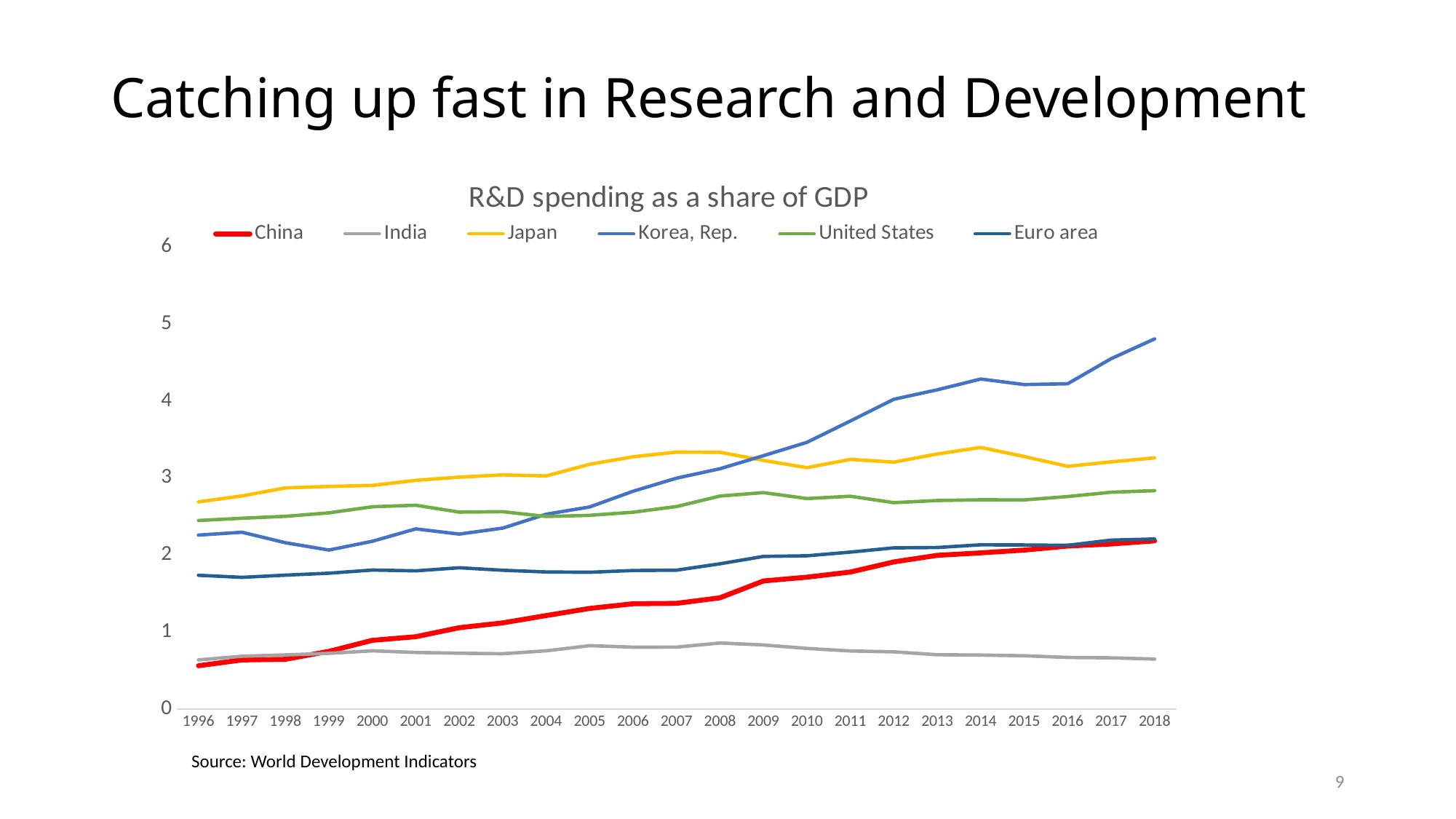
In 2018, which is larger, the value for Korea, Rep. or the value for Japan? Korea, Rep. Is the value for Korea, Rep. in 2018 greater or less than 4? greater Is the value for China in 1996 greater or less than 1? less How many years are shown on the x axis? 23 Does the value for Korea, Rep. rise or fall from 2008 to 2018? rise What is the title of the chart? R&D spending as a share of GDP How many series does the legend list? 6 What kind of chart is shown on the slide? line chart Is the value for India in 2018 greater or less than 1? less Which series has the lowest value in 2018? India Which series has the highest value in 2018? Korea, Rep. Does the value for China rise or fall from 1996 to 2018? rise